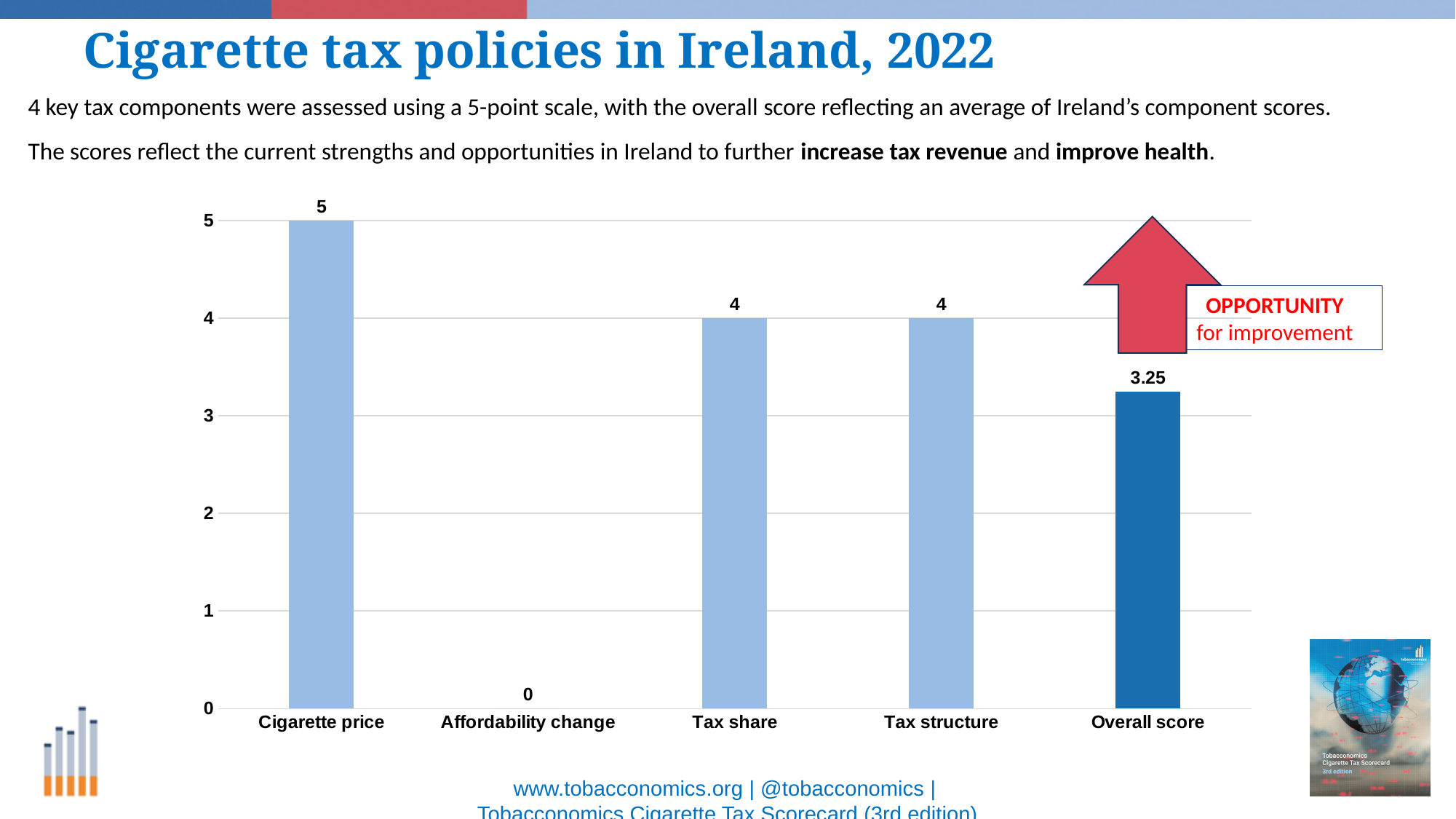
Is the value for Overall score greater or less than 3? greater What is the value for Cigarette price? 5 Which category has the highest value? Cigarette price How many categories are shown on the x axis? 5 What is the value for Tax share? 4 Which category has the lowest value? Affordability change Which is larger, the value for Cigarette price or the value for Overall score? Cigarette price What is the difference between the values for Cigarette price and Tax structure? 1 What is the value for Affordability change? 0 What is the Overall score shown on the chart? 3.25 What kind of chart is shown on the slide? Bar chart What is the difference between the values for Tax share and Overall score? 0.75